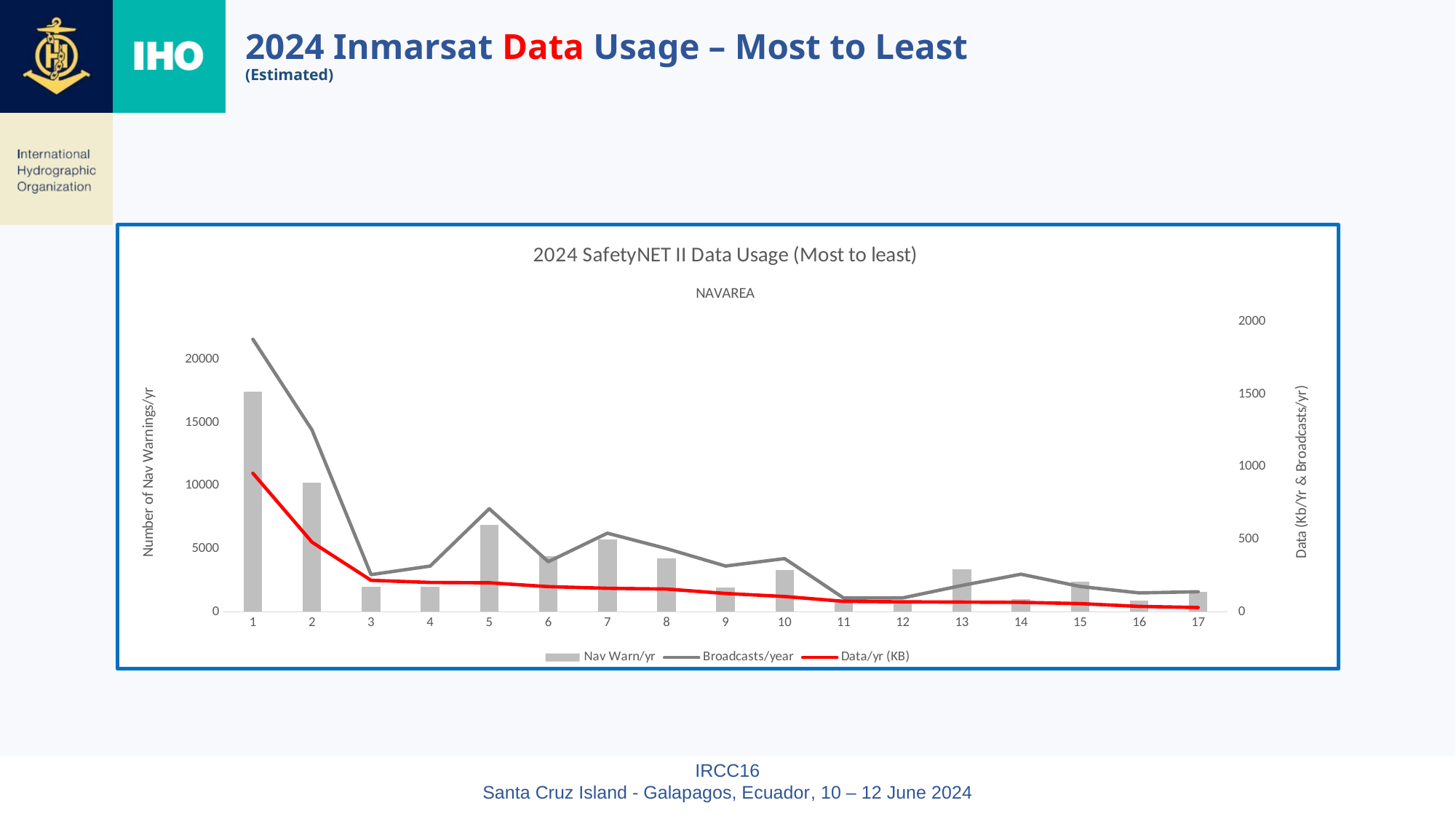
Is the Nav Warn/yr value for NAVAREA 2 greater or less than 15000? less Which has the larger Nav Warn/yr bar, NAVAREA 12 or NAVAREA 13? NAVAREA 13 Which NAVAREA has the highest Nav Warn/yr bar? 1 How many series does the legend list? 3 Is the Nav Warn/yr value for NAVAREA 1 greater or less than 15000? greater What is the title of the chart? 2024 SafetyNET II Data Usage (Most to least) Is the Nav Warn/yr value for NAVAREA 5 greater or less than 5000? greater Do the Data/yr (KB) values generally rise or fall from NAVAREA 1 to NAVAREA 17? fall How many NAVAREA categories are plotted along the x axis? 17 What kind of chart is shown on the slide? A combined bar and line chart